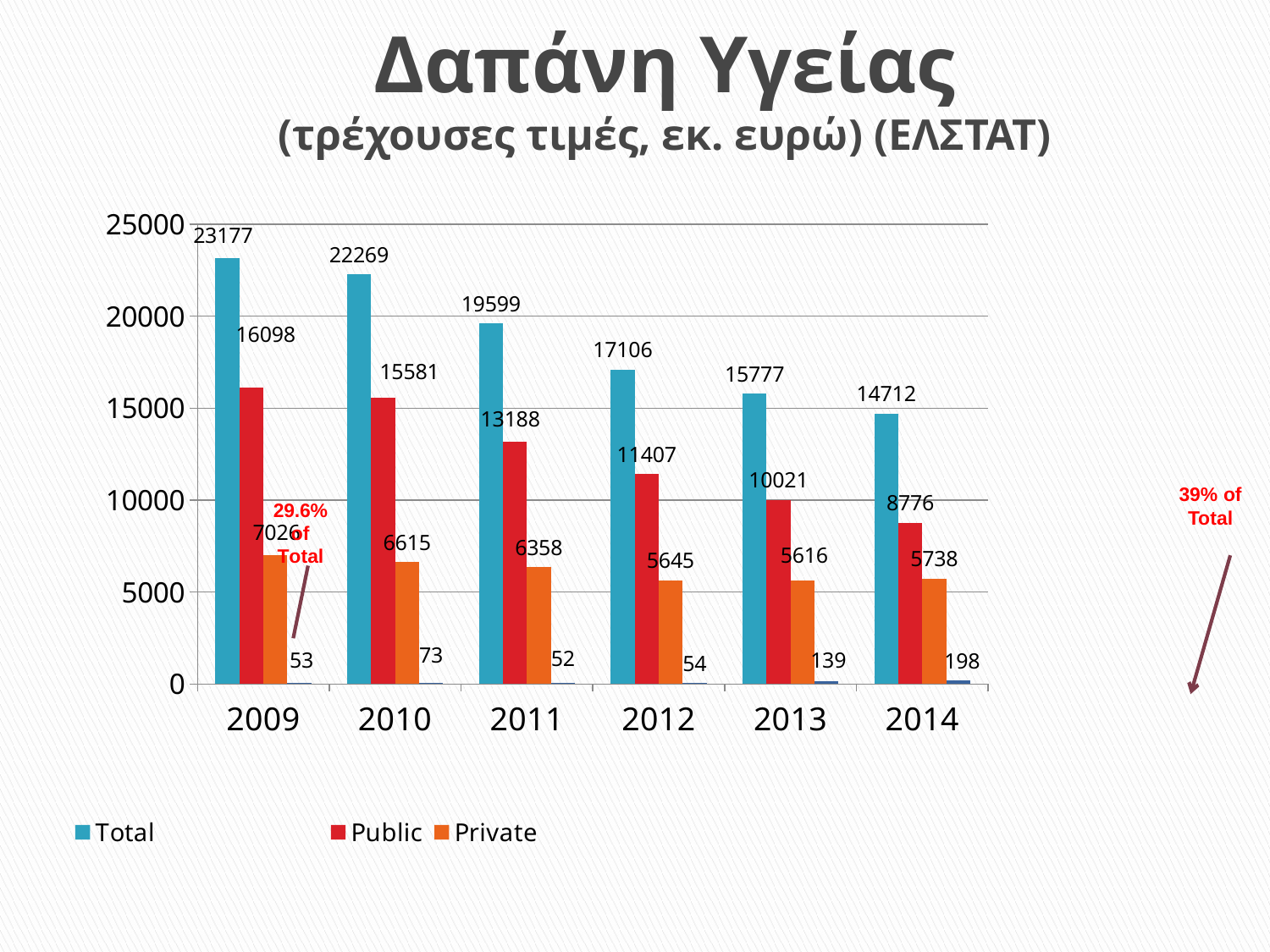
Which year has the lowest Public value? 2014 Do the Total values rise or fall from 2009 to 2014? fall How many series does the legend list? 3 What is the Total value for 2009? 23177 How many years are shown on the x axis? 6 What is the Public value for 2012? 11407 Which year has the highest Total value? 2009 Is the Public value for 2011 greater or less than 15000? less Which is larger, the Private value for 2010 or the Private value for 2013? 2010 What kind of chart is shown on the slide? bar chart What is the Private value for 2014? 5738 What is the difference between the Total values for 2009 and 2014? 8465